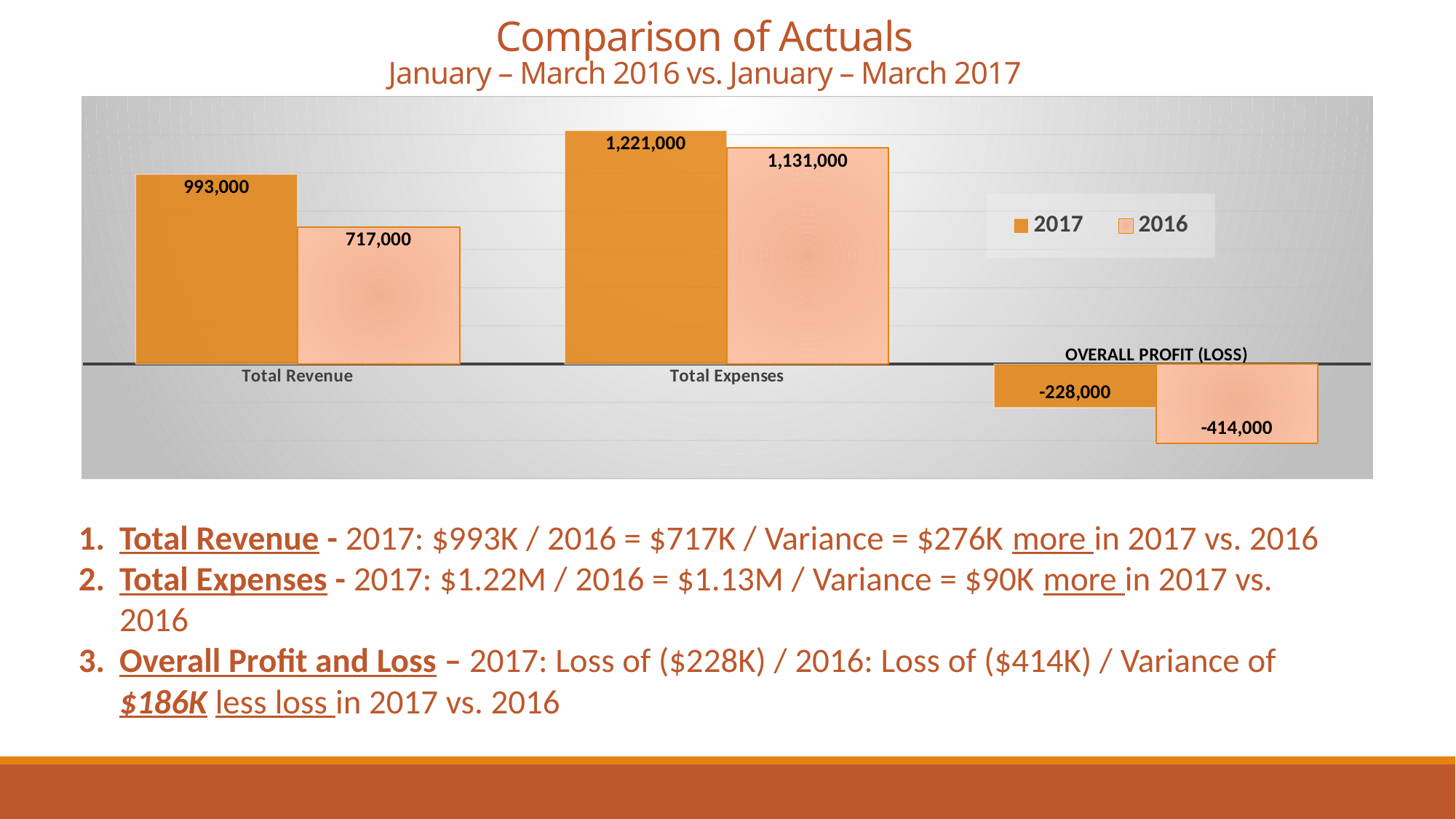
What is the Overall Profit (Loss) value for 2016? -414,000 What is the Total Expenses value for 2016? 1,131,000 What is the Overall Profit (Loss) value for 2017? -228,000 What kind of chart is shown on the slide? Bar chart What is the Total Expenses value for 2017? 1,221,000 How many series does the legend list? 2 Which is larger, Total Expenses for 2017 or Total Expenses for 2016? 2017 What is the Total Revenue value for 2016? 717,000 What is the difference between the 2017 and 2016 Total Revenue values? 276,000 Which category has the highest value for the 2017 series? Total Expenses What is the Total Revenue value for 2017? 993,000 Which category has the lowest value for the 2016 series? Overall Profit (Loss)